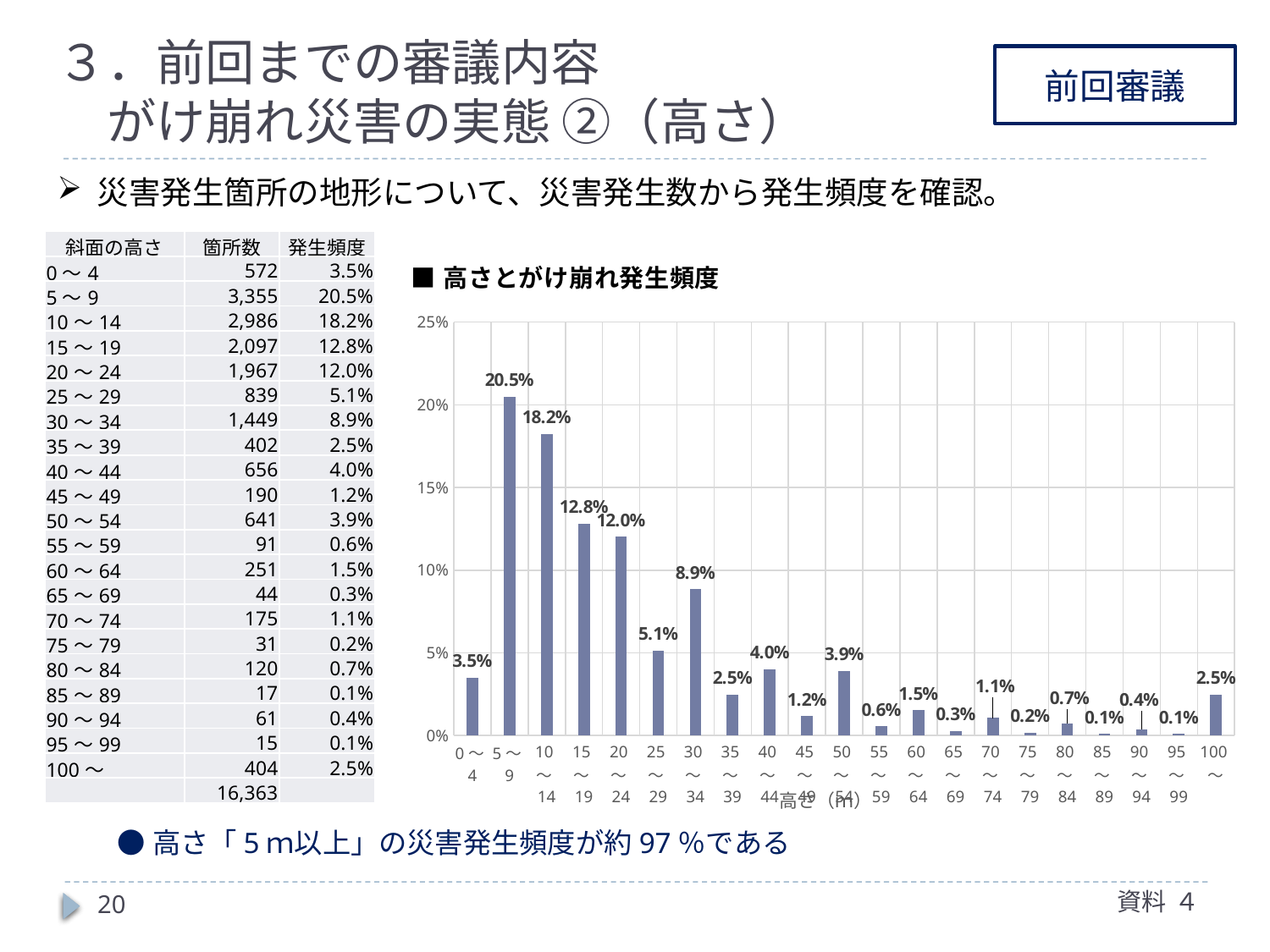
Which is larger, the value for 25～29 or the value for 30～34? 30～34 Do the values rise or fall from the 5～9 category to the 25～29 category? fall How many categories are shown on the x axis of the chart? 21 Which category has the highest value? 5～9 What is the value for the 30～34 category? 8.9% Is the value for 10～14 greater or less than 15%? greater What is the title of the chart? 高さとがけ崩れ発生頻度 What is the value for the 0～4 category? 3.5% What is the difference between the values for 5～9 and 10～14? 2.3% What is the value for the 100～ category? 2.5% What kind of chart is shown on the slide? bar chart What is the value for the 5～9 category in the 高さとがけ崩れ発生頻度 chart? 20.5%